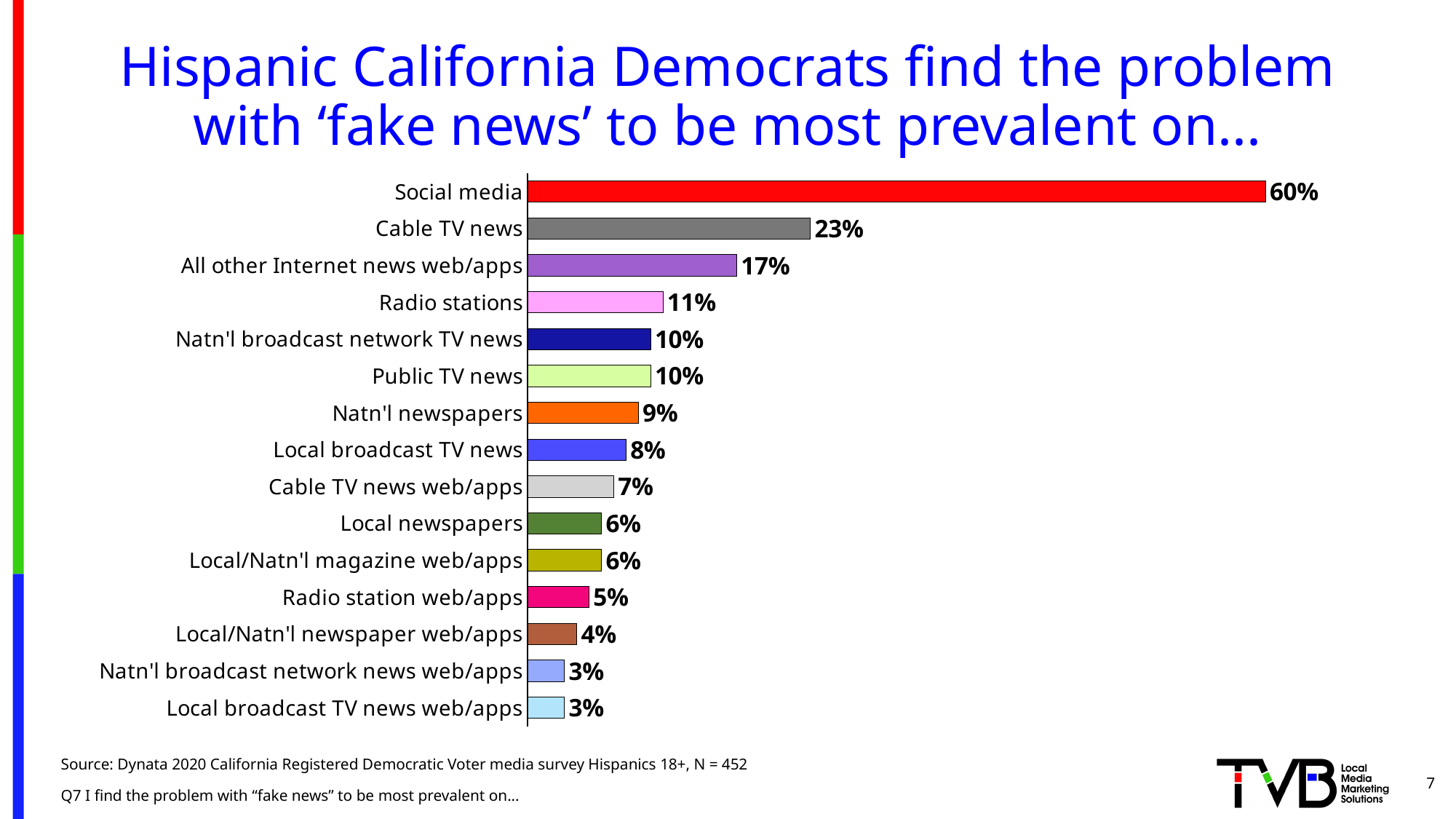
What is the value shown for Cable TV news? 23% What is the difference between the values for All other Internet news web/apps and Radio stations? 6% What is the value shown for Local/Natn'l newspaper web/apps? 4% Which is larger, the value for Natn'l newspapers or the value for Local broadcast TV news? Natn'l newspapers What kind of chart is shown on the slide? Bar chart What percentage of Hispanic California Democrats find the problem with 'fake news' most prevalent on Social media? 60% What is the difference between the values for Social media and Cable TV news? 37% How many categories are shown in the chart? 15 Which is larger, the value for Cable TV news web/apps or the value for Radio station web/apps? Cable TV news web/apps What is the value shown for Radio stations? 11% Which category has the highest value in the chart? Social media What colour is the bar for Social media? Red